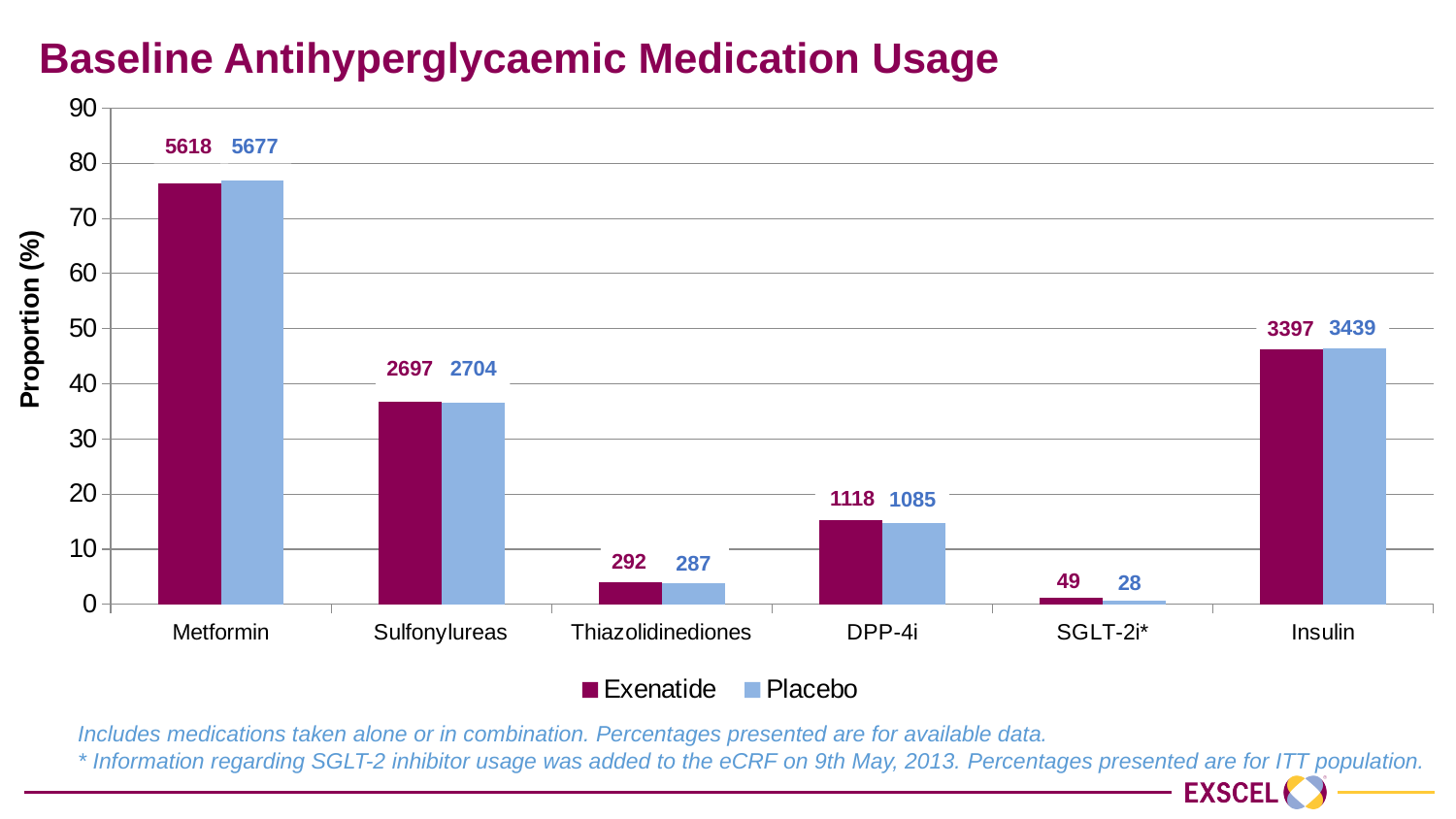
For Metformin, which group has the larger printed number, Exenatide or Placebo? Placebo How many series does the legend list? 2 What number is printed above the Exenatide bar for SGLT-2i*? 49 What kind of chart is shown on the slide? Bar chart Is the Placebo proportion for Metformin greater or less than 70%? greater Which medication category has the lowest proportion for both Exenatide and Placebo? SGLT-2i* Which medication category has the highest proportion for both Exenatide and Placebo? Metformin What number is printed above the Exenatide bar for Metformin? 5618 Is the Exenatide proportion for Sulfonylureas greater or less than 40%? less What is the difference between the numbers printed for Exenatide and Placebo in the SGLT-2i* category? 21 What number is printed above the Placebo bar for Insulin? 3439 How many medication categories are shown on the x axis? 6